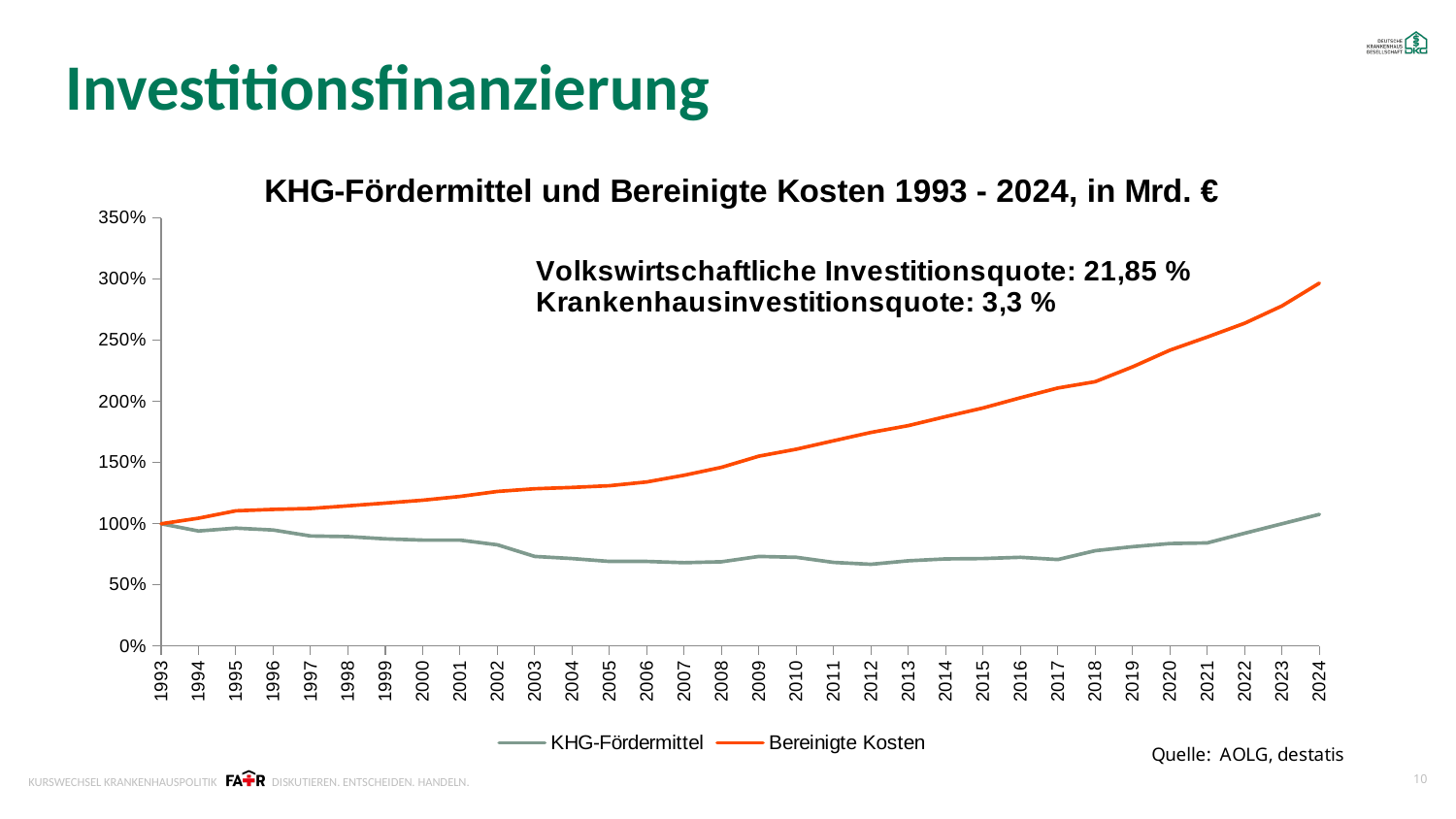
What Krankenhausinvestitionsquote is stated in the text on the chart? 3,3 % Is the value for Bereinigte Kosten in 2024 greater or less than 250%? greater Which series has the larger value in 2024, KHG-Fördermittel or Bereinigte Kosten? Bereinigte Kosten What kind of chart is shown on the slide? line chart In which year does Bereinigte Kosten reach its highest value? 2024 Does the Bereinigte Kosten line rise or fall from 1993 to 2024? rise What is the value of Bereinigte Kosten in 1993? 100% How many series does the chart legend list? 2 What is the value of KHG-Fördermittel in 1993? 100% How many years are plotted along the x axis of the chart? 32 Is the value for KHG-Fördermittel in 2012 greater or less than 100%? less Is the value for Bereinigte Kosten in 2010 greater or less than 150%? greater